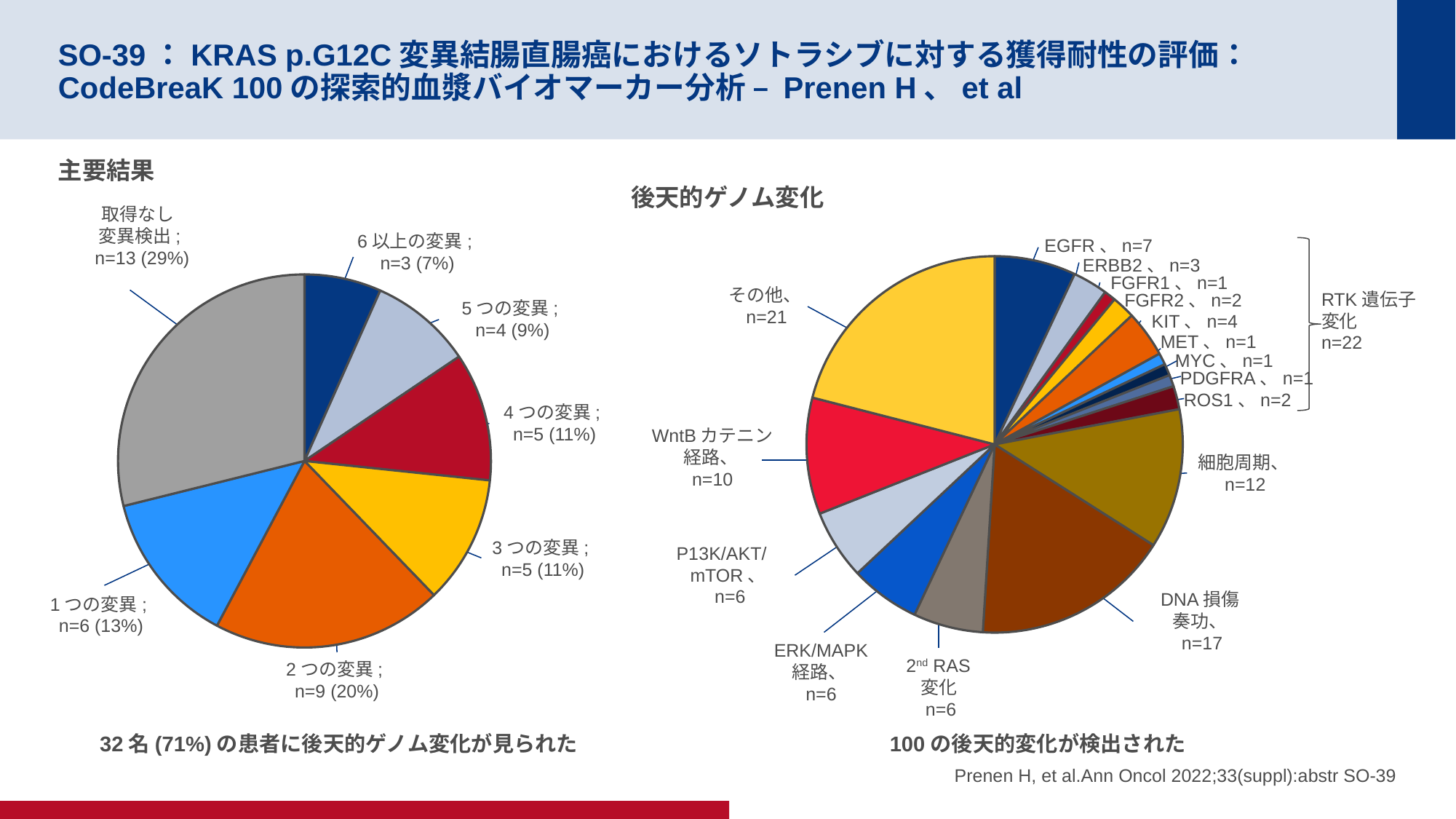
このスライドの 2 つのグラフはどの種類のグラフですか？ 円グラフ 「後天的ゲノム変化」の円グラフで、「その他」と「DNA 損傷奏功」の n の差はいくつですか？ 4 「後天的ゲノム変化」の円グラフで、「DNA 損傷奏功」の値はいくつですか？ n=17 「後天的ゲノム変化」の円グラフで、「細胞周期」と「WntB カテニン経路」ではどちらが大きいですか？ 細胞周期 左側の円グラフで、「2 つの変異」の値はいくつですか？ n=9 (20%) 左側の円グラフで、「1 つの変異」と「5 つの変異」の n の差はいくつですか？ 2 「後天的ゲノム変化」の円グラフで、KIT の値はいくつですか？ n=4 左側の円グラフには区分がいくつありますか？ 7 左側の円グラフで、「取得なし変異検出」の割合は何%ですか？ 29% 「後天的ゲノム変化」の円グラフで、RTK 遺伝子変化の合計 n はいくつですか？ n=22 左側の円グラフで、最も小さい区分はどれですか？ 6 以上の変異 「後天的ゲノム変化」の円グラフで、最も大きい区分はどれですか？ その他